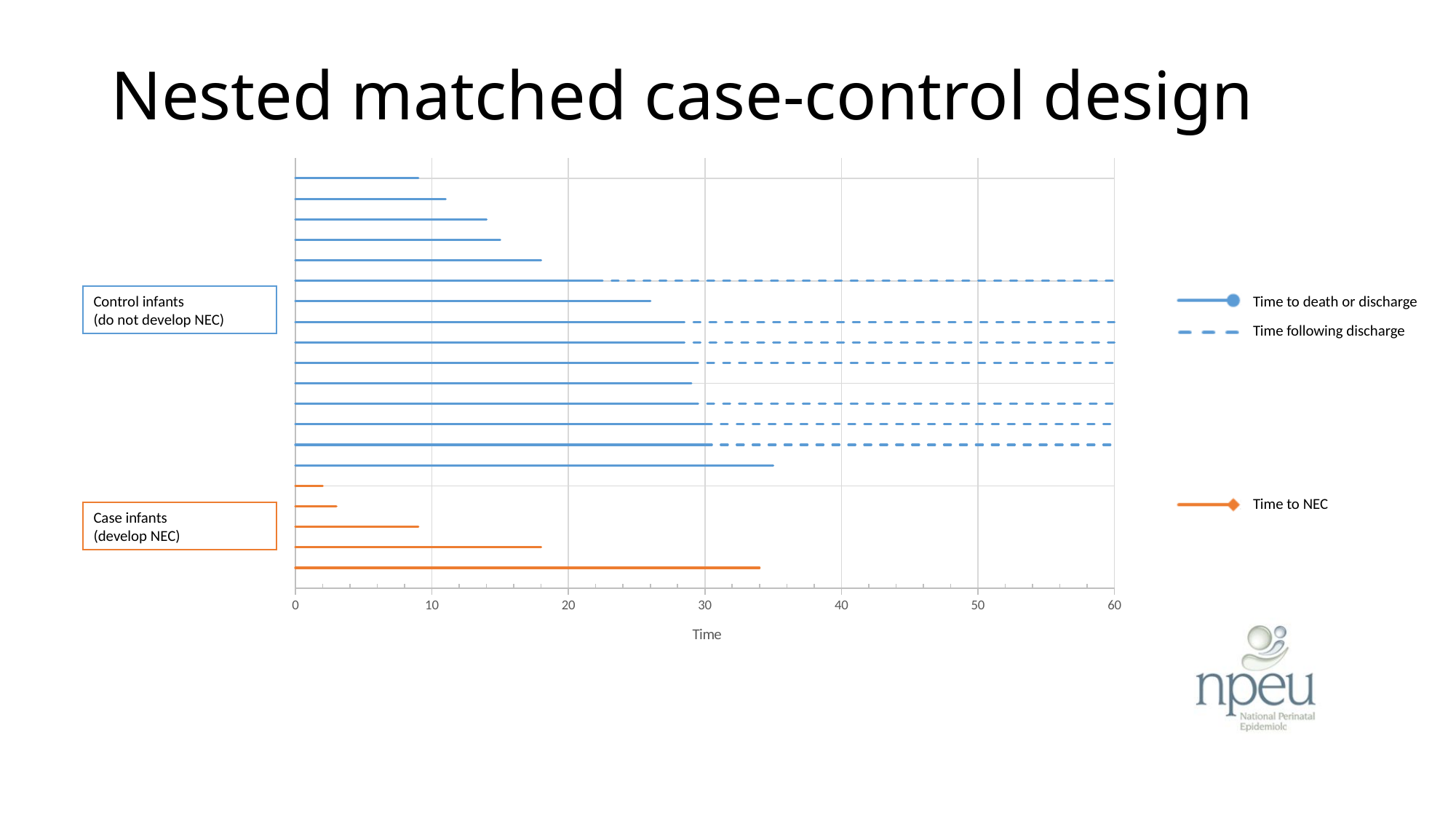
Is the shortest orange 'Time to NEC' bar greater or less than 10? less How many entries does the legend list? 3 Is the longest orange 'Time to NEC' bar greater or less than 30? greater Which legend entry is shown with a dashed line? Time following discharge Is the longest solid blue 'Time to death or discharge' bar greater or less than 30? greater What kind of chart is shown on the slide? line chart How many orange bars (case infants) are plotted? 5 Which is longer: the longest orange 'Time to NEC' bar or the shortest blue 'Time to death or discharge' bar? the longest orange 'Time to NEC' bar What is the title of the x axis? Time How many blue rows (control infants) are plotted? 15 How many rows include a dashed 'Time following discharge' segment? 7